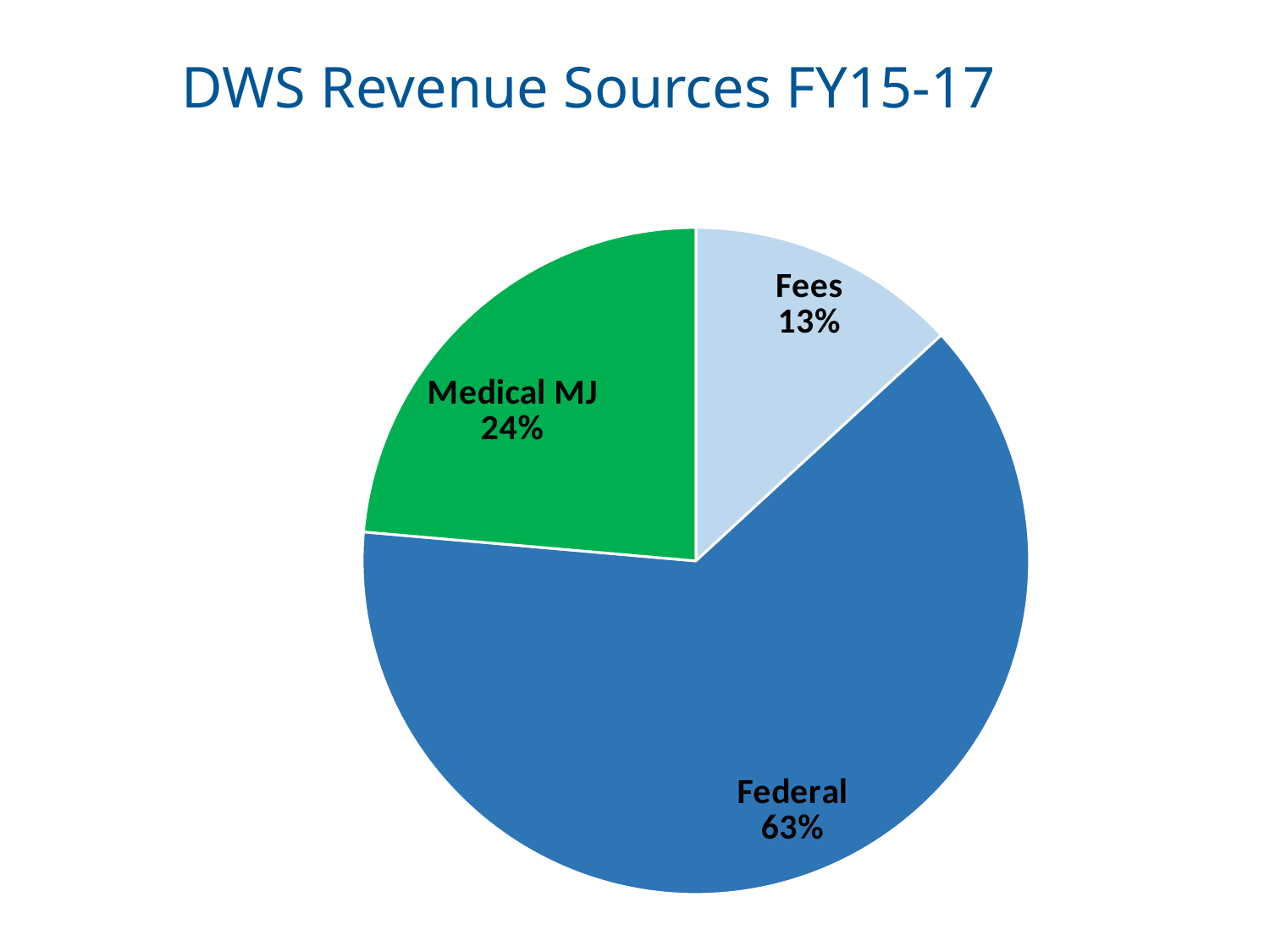
How many slices does the pie chart have? 3 What share of revenue comes from Medical MJ? 24% Which is larger, the share for Medical MJ or the share for Fees? Medical MJ What is the difference in percentage points between the Federal and Medical MJ shares? 39 What share of revenue comes from Federal sources? 63% What kind of chart is shown on the slide? pie chart Which revenue source has the smallest share? Fees Which revenue source has the largest share? Federal What share of revenue comes from Fees? 13% What is the difference in percentage points between the Medical MJ and Fees shares? 11 What colour is the Medical MJ slice? green What is the title of the chart? DWS Revenue Sources FY15-17